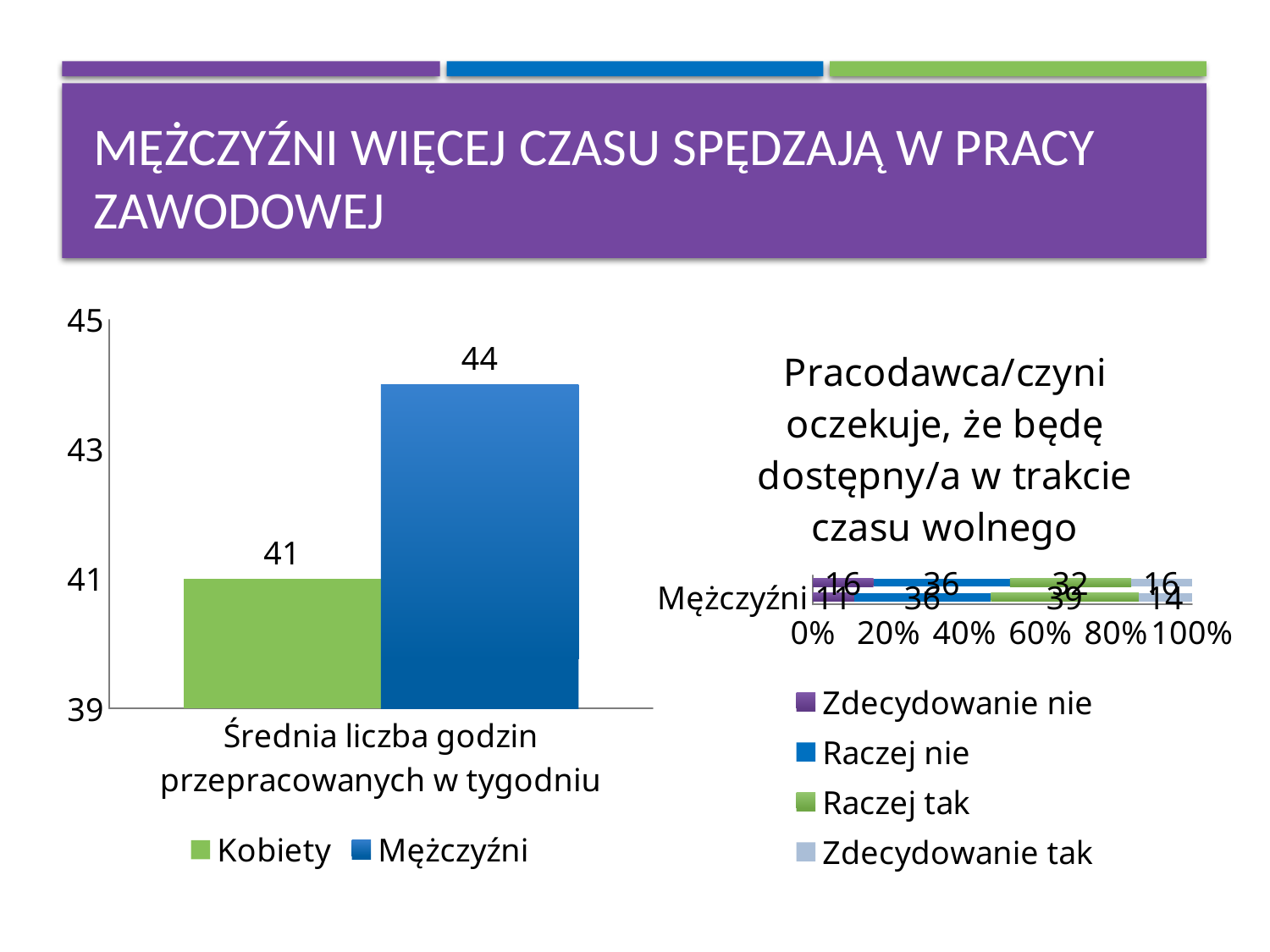
In the left bar chart, what is the average number of hours worked per week for Kobiety? 41 What kind of chart is the chart on the left of the slide? bar chart In the left bar chart, how many series does the legend list? 2 In the left bar chart, which series has the lowest value? Kobiety In the chart on the right of the slide, how many series does the legend list? 4 What is the title of the chart on the right of the slide? Pracodawca/czyni oczekuje, że będę dostępny/a w trakcie czasu wolnego In the left bar chart, which series has the higher value, Kobiety or Mężczyźni? Mężczyźni In the left bar chart, what is the average number of hours worked per week for Mężczyźni? 44 In the left bar chart, what is the difference between the Mężczyźni and Kobiety values? 3 In the left bar chart, how many categories are shown on the x axis? 1 In the chart on the right of the slide, which legend entry is shown in purple? Zdecydowanie nie In the left bar chart, is the value for Mężczyźni greater or less than 43? greater